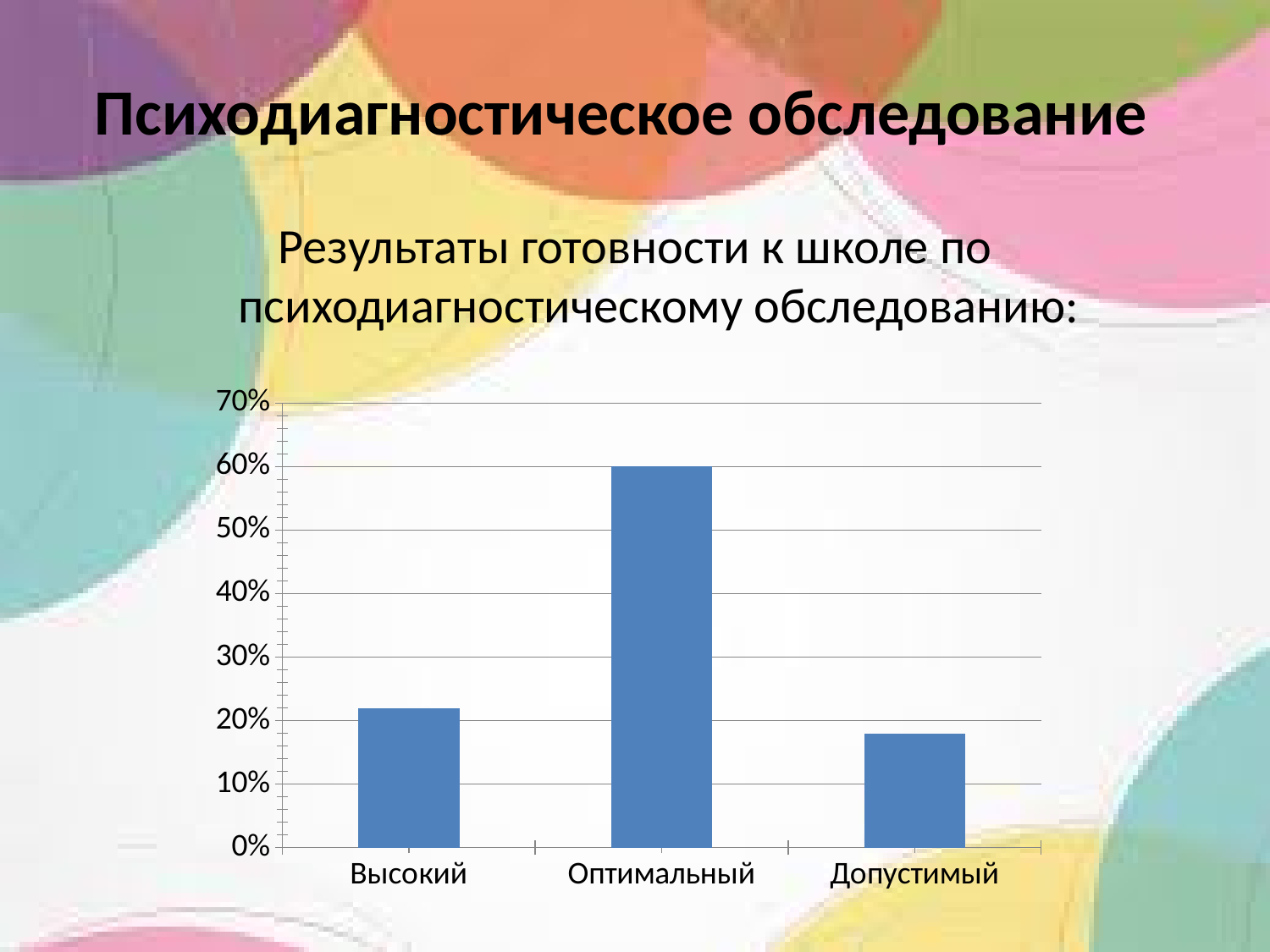
What is the value for Оптимальный? 60% Which category has the lowest value in the chart? Допустимый What kind of chart is shown on the slide? bar chart Which category has the highest value in the chart? Оптимальный How many categories are shown on the x axis of the chart? 3 Which is larger, the value for Высокий or the value for Допустимый? Высокий Is the value for Высокий greater or less than 20%? greater What is the label of the first category on the x axis? Высокий Is the value for Оптимальный greater or less than 50%? greater Is the value for Высокий greater or less than 30%? less What is the highest value shown on the vertical axis of the chart? 70%